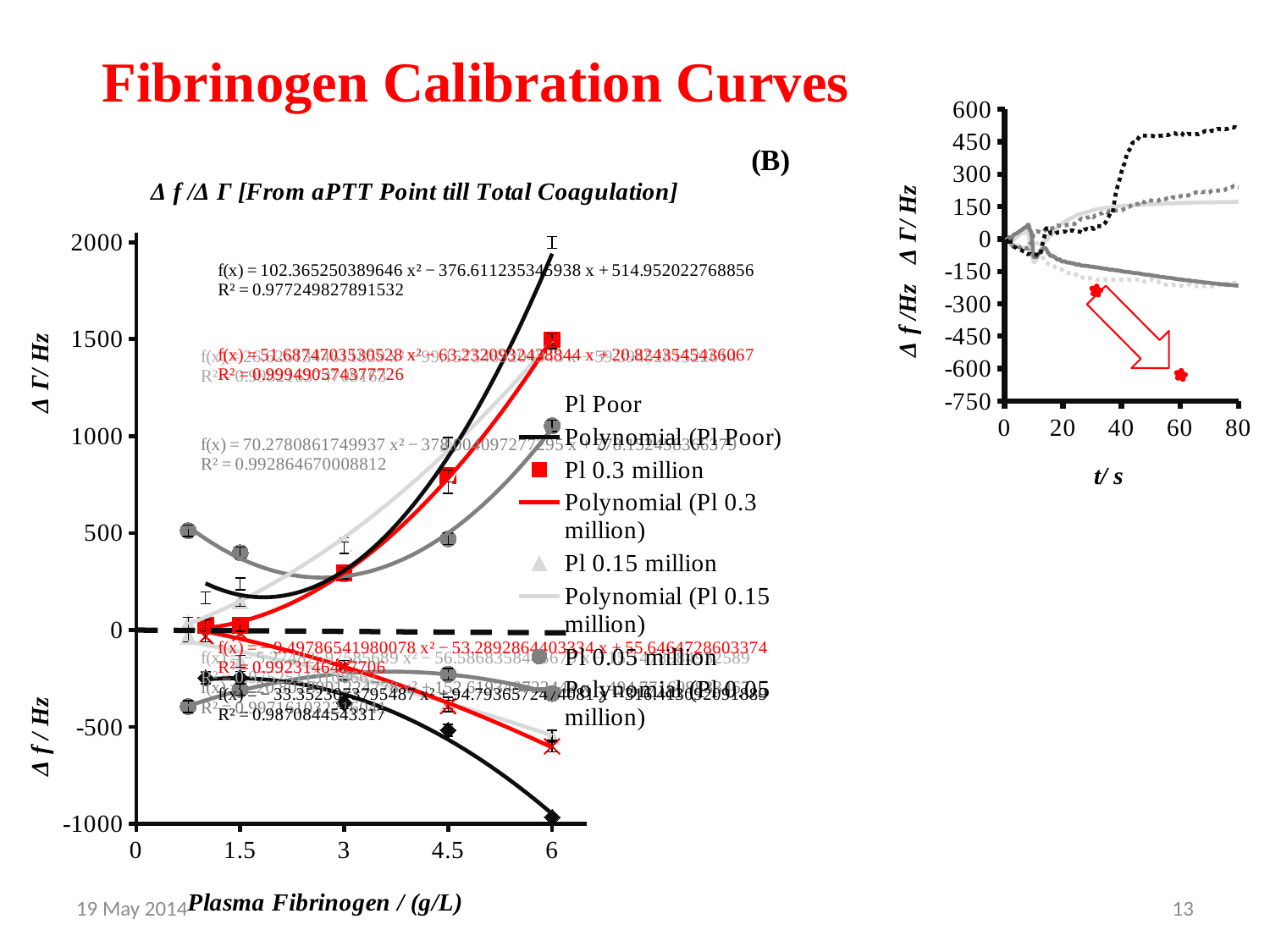
What is the x-axis label of the main chart on the left? Plasma Fibrinogen / (g/L) In the main chart on the left, is the value for Pl 0.3 million at 3 g/L greater or less than 500? less In the main chart on the left, is the value for Pl 0.3 million at 4.5 g/L greater or less than 500? greater In the main chart on the left, what is the highest value shown on the y-axis? 2000 In the small chart in the top right, does the black dotted line rise or fall between t = 20 s and t = 60 s? rise What is the x-axis label of the small chart in the top right? t/ s In the main chart on the left, is the lowest black diamond point at 6 g/L greater or less than -500? less In the main chart on the left, how many tick labels are shown on the x-axis? 5 In the main chart on the left, does the Pl 0.3 million series rise or fall as plasma fibrinogen increases from 1.5 to 6 g/L? rise What is the title of the main chart on the left? Δ f /Δ Γ [From aPTT Point till Total Coagulation] In the main chart on the left, how many entries does the legend list? 8